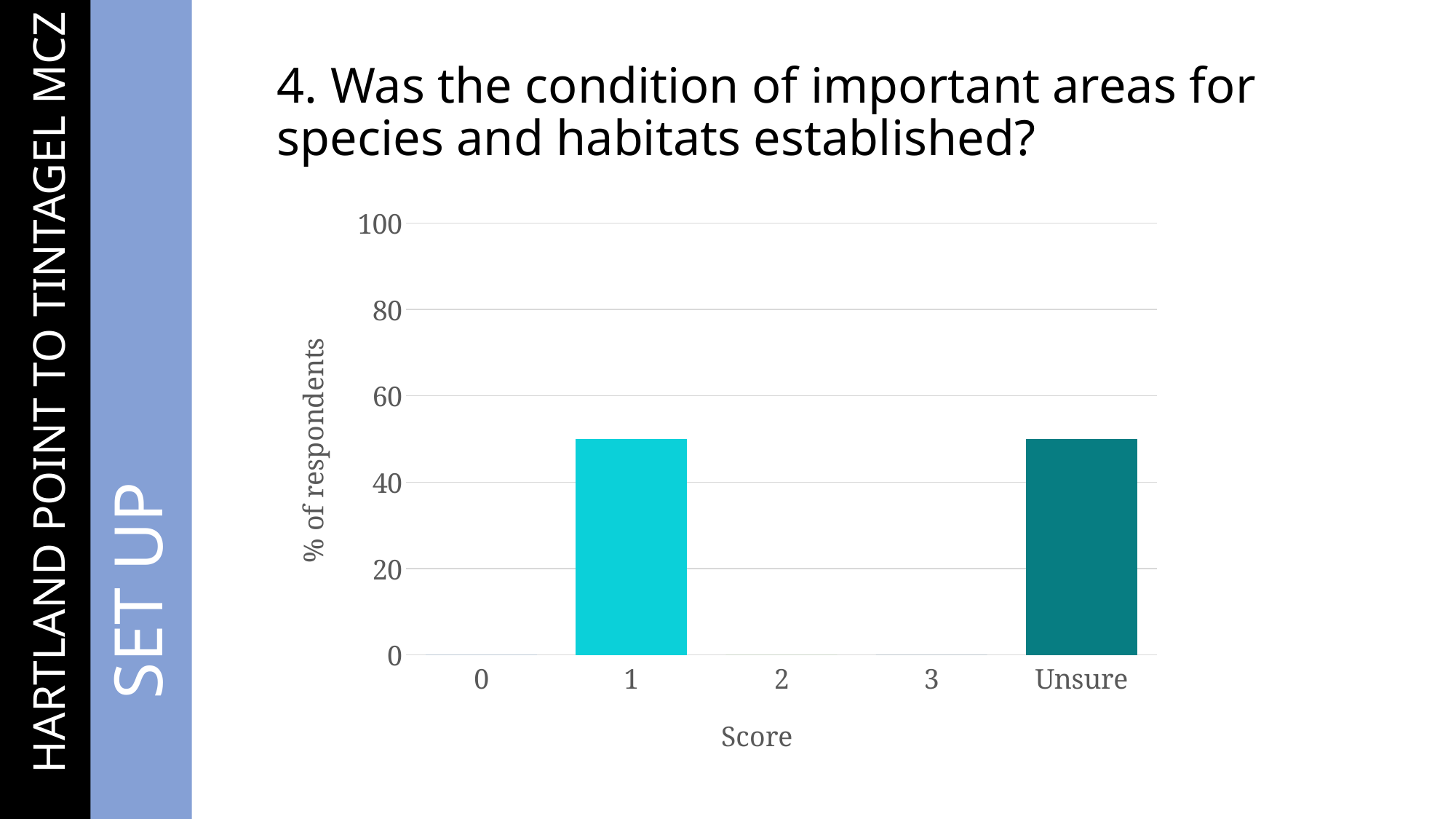
What is the label of the x axis of the chart? Score Which has the larger value, score 3 or Unsure? Unsure Is the value for Unsure greater or less than 60? less What kind of chart is shown on the slide? bar chart What is the label of the y axis of the chart? % of respondents How many score categories are shown on the x axis of the chart? 5 Is the value for score 1 greater or less than 40? greater Is the value for score 1 greater or less than 60? less Which has the larger value, score 1 or score 0? 1